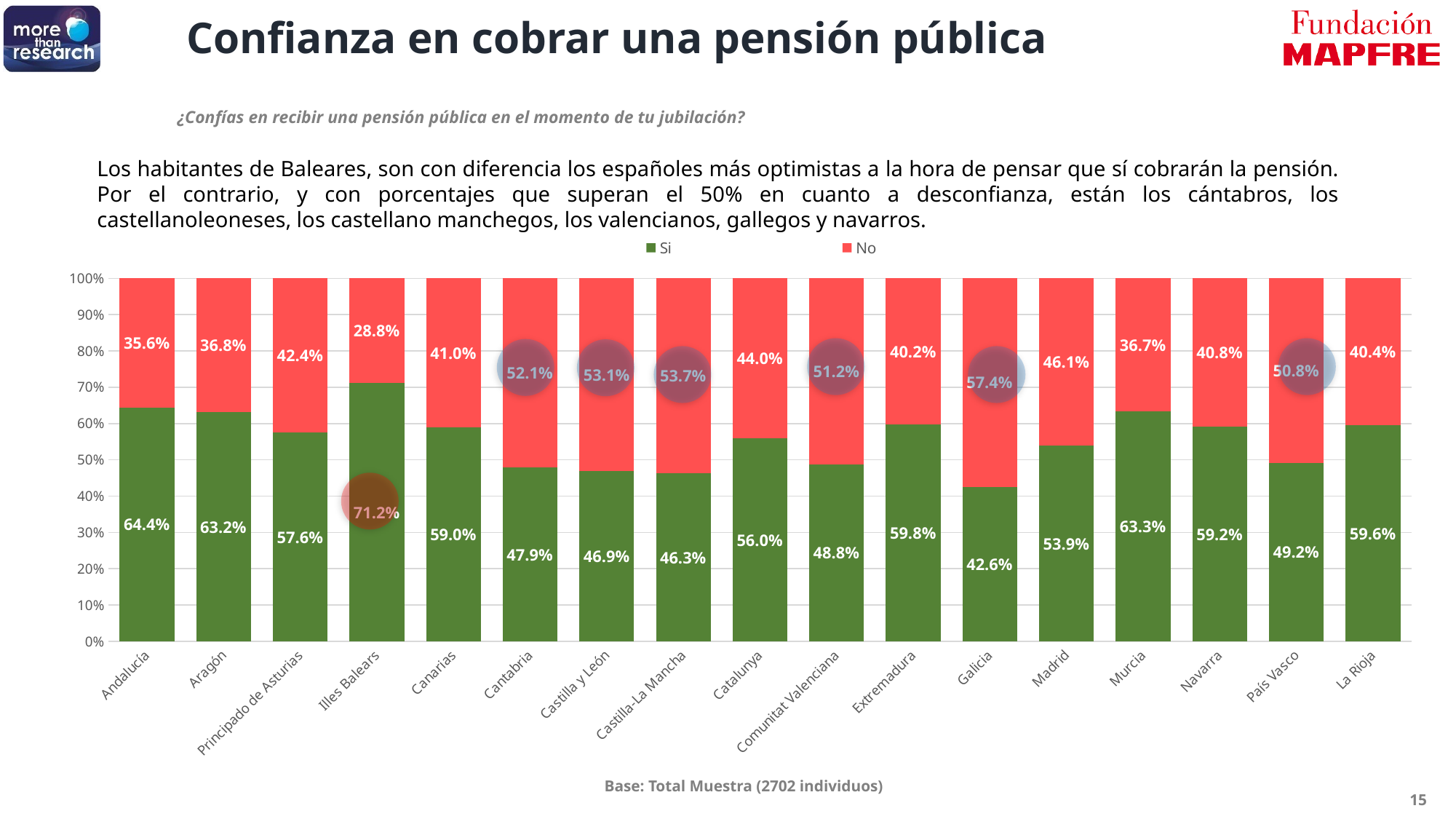
What is the total of the stacked bar for Cantabria? 100% What is the 'No' value for Galicia? 57.4% Which region has the lowest 'No' value? Illes Balears What is the difference between the 'Si' values for Andalucía and Aragón? 1.2% What type of chart is shown on the slide? Stacked bar chart Which region has the highest 'Si' value? Illes Balears Which is larger, the 'Si' value for Madrid or the 'Si' value for Murcia? Murcia How many regions are shown on the x axis of the chart? 17 What is the 'Si' value for Comunitat Valenciana? 48.8% What is the 'Si' value for Illes Balears? 71.2% Which region has the lowest 'Si' value? Galicia How many series does the legend list? 2